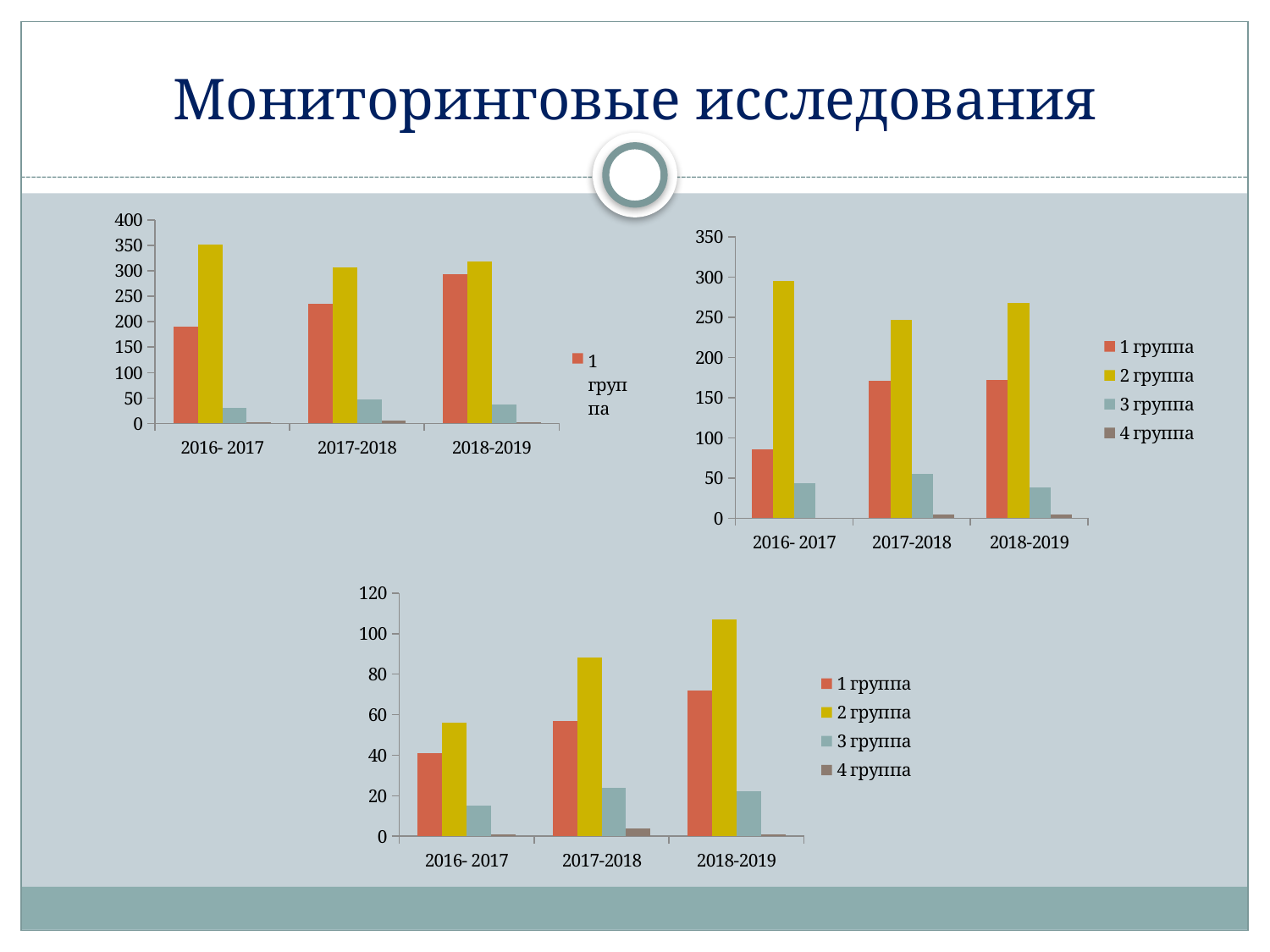
In the top-left chart, which category has the highest value for the red (1 группа) series? 2018-2019 In the bottom chart, do the values for 1 группа rise or fall from 2016-2017 to 2018-2019? rise In the top-right chart, is the value for 2 группа in 2016-2017 greater or less than 250? greater In the bottom chart, which is larger in 2017-2018: 1 группа or 2 группа? 2 группа In the top-right chart, which series has the highest value in 2018-2019? 2 группа In the bottom chart, is the value for 1 группа in 2016-2017 greater or less than 60? less How many categories are shown on the x axis of the bottom chart? 3 What is the title of the slide? Мониторинговые исследования How many series does the legend of the top-right chart list? 4 In the top-right chart, which category has the lowest value for 1 группа? 2016- 2017 In the bottom chart, is the value for 2 группа in 2018-2019 greater or less than 100? greater What kind of chart is the chart at the top left of the slide? bar chart